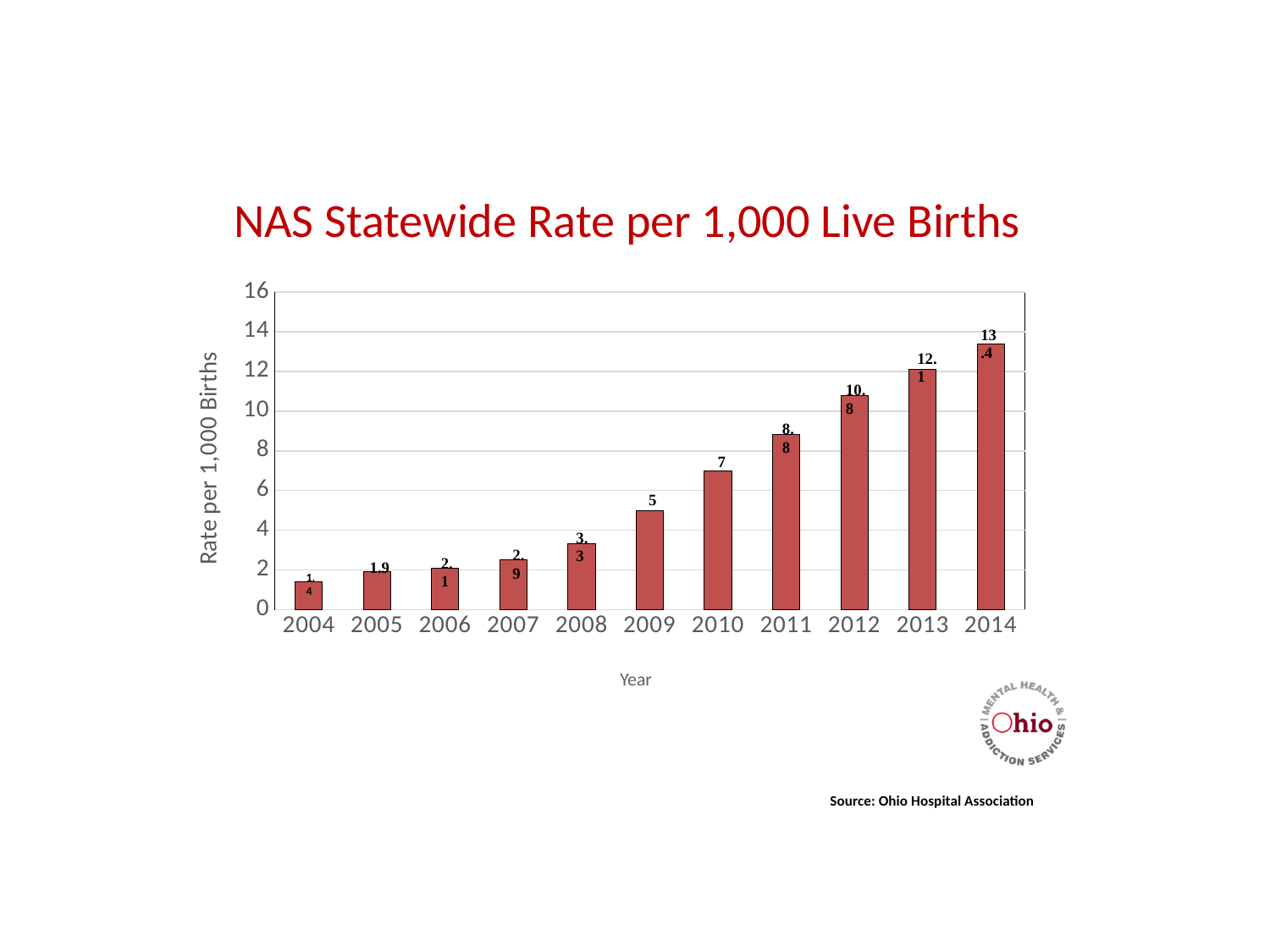
Do the rates rise or fall from 2004 to 2014? rise What is the rate per 1,000 births for 2009? 5 Which year has a higher rate, 2010 or 2012? 2012 Which year has the lowest rate? 2004 How many years are plotted on the x axis? 11 What type of chart is shown on the slide? bar chart Is the value for 2013 greater or less than 10? greater Which year has the highest rate? 2014 What is the rate per 1,000 births for 2011? 8.8 What is the rate per 1,000 births for 2014? 13.4 What is the difference between the rates for 2014 and 2004? 12 What is the title of the chart? NAS Statewide Rate per 1,000 Live Births